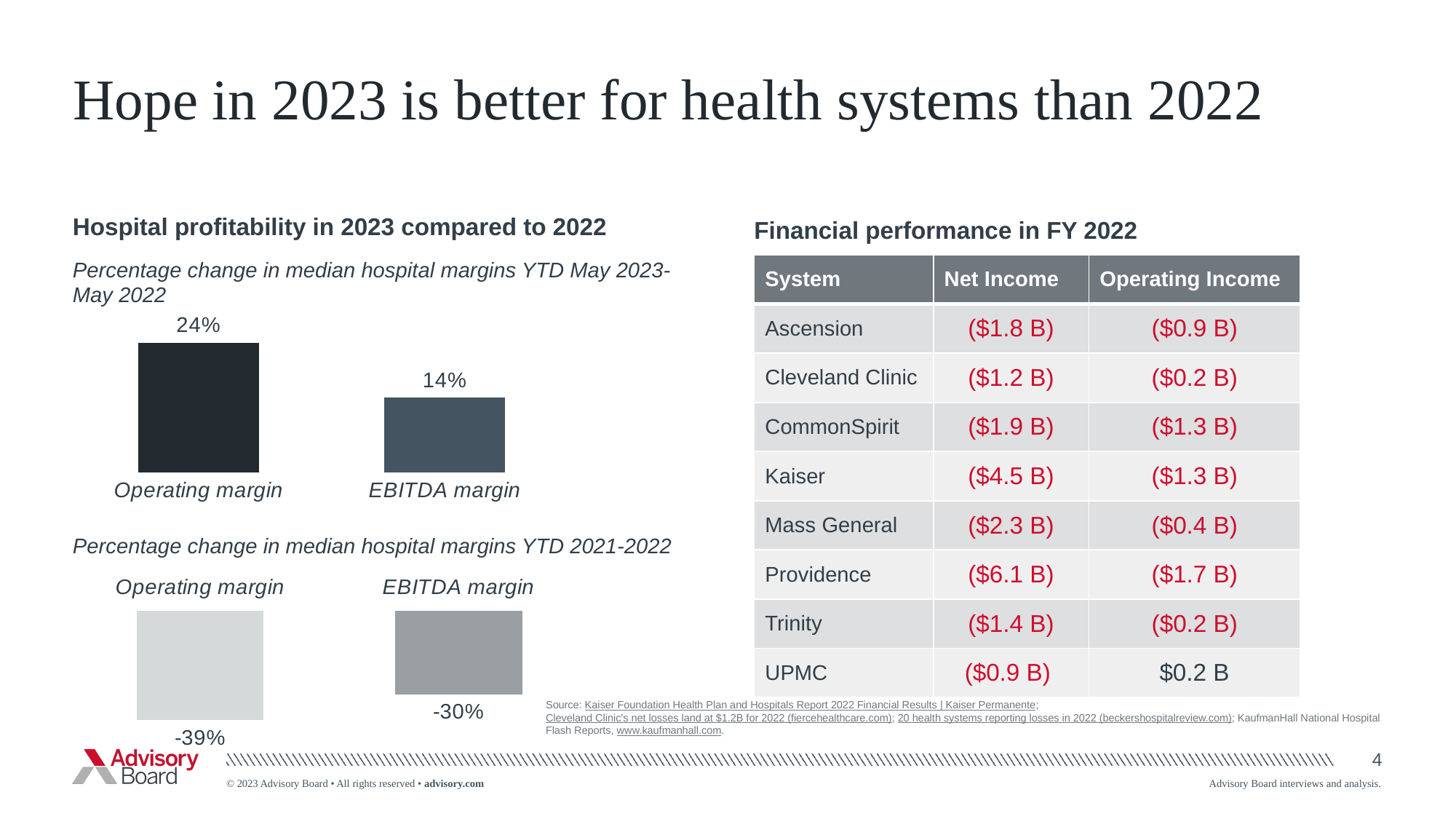
In the chart 'Percentage change in median hospital margins YTD 2021-2022', which category has the lowest value? Operating margin In the chart 'Percentage change in median hospital margins YTD May 2023-May 2022', what is the value for EBITDA margin? 14% What type of chart is used for 'Percentage change in median hospital margins YTD 2021-2022'? Bar chart In the chart 'Percentage change in median hospital margins YTD May 2023-May 2022', what is the value for Operating margin? 24% In the chart 'Percentage change in median hospital margins YTD 2021-2022', what is the value for EBITDA margin? -30% In the chart 'Percentage change in median hospital margins YTD May 2023-May 2022', what is the difference between the Operating margin and EBITDA margin values? 10 percentage points In the chart 'Percentage change in median hospital margins YTD 2021-2022', what is the value for Operating margin? -39% How many categories are shown in the chart 'Percentage change in median hospital margins YTD May 2023-May 2022'? 2 In the chart 'Percentage change in median hospital margins YTD 2021-2022', what is the difference between the EBITDA margin and Operating margin values? 9 percentage points What is the heading above the two charts on the left side of the slide? Hospital profitability in 2023 compared to 2022 In the chart 'Percentage change in median hospital margins YTD 2021-2022', which is larger, Operating margin or EBITDA margin? EBITDA margin In the chart 'Percentage change in median hospital margins YTD May 2023-May 2022', which category has the highest value? Operating margin